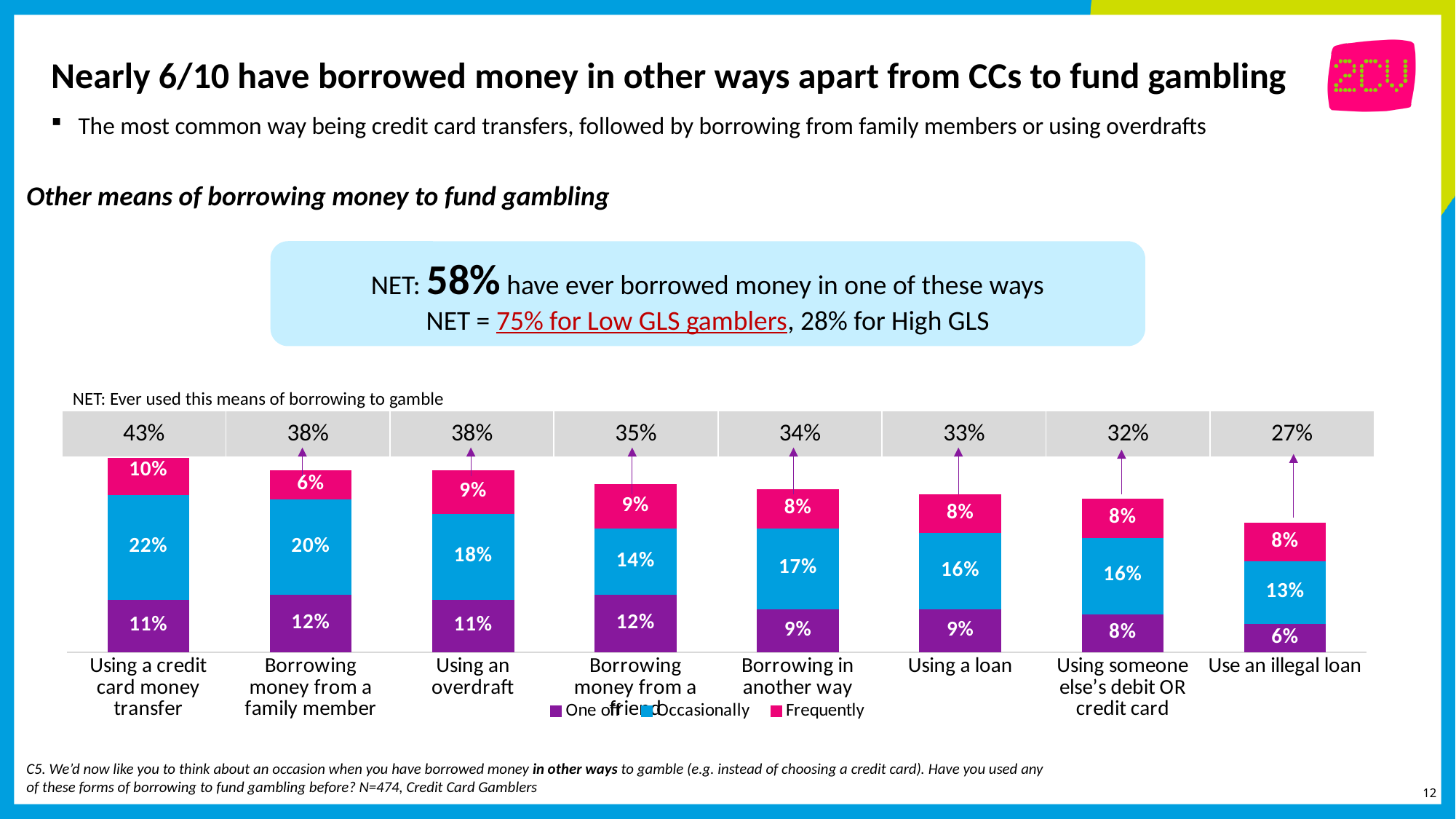
What is the 'Occasionally' value for 'Borrowing money from a family member'? 20% What is the 'One off' value for 'Use an illegal loan'? 6% Which is larger: the 'One off' value for 'Borrowing money from a friend' or the 'One off' value for 'Borrowing in another way'? Borrowing money from a friend How many categories (means of borrowing) are shown in the chart? 8 What is the total of the stacked bar for 'Using someone else's debit OR credit card'? 32% Which category has the highest NET value for ever having used that means of borrowing? Using a credit card money transfer What is the difference between the 'Occasionally' values for 'Using a credit card money transfer' and 'Using an overdraft'? 4% What type of chart is used to show the other means of borrowing money to fund gambling? Stacked bar chart What is the NET 'Ever used this means of borrowing to gamble' value for 'Using a loan'? 33% Which category has the lowest NET value for ever having used that means of borrowing? Use an illegal loan What is the 'Frequently' value for 'Using a credit card money transfer'? 10% How many series does the chart legend list? 3